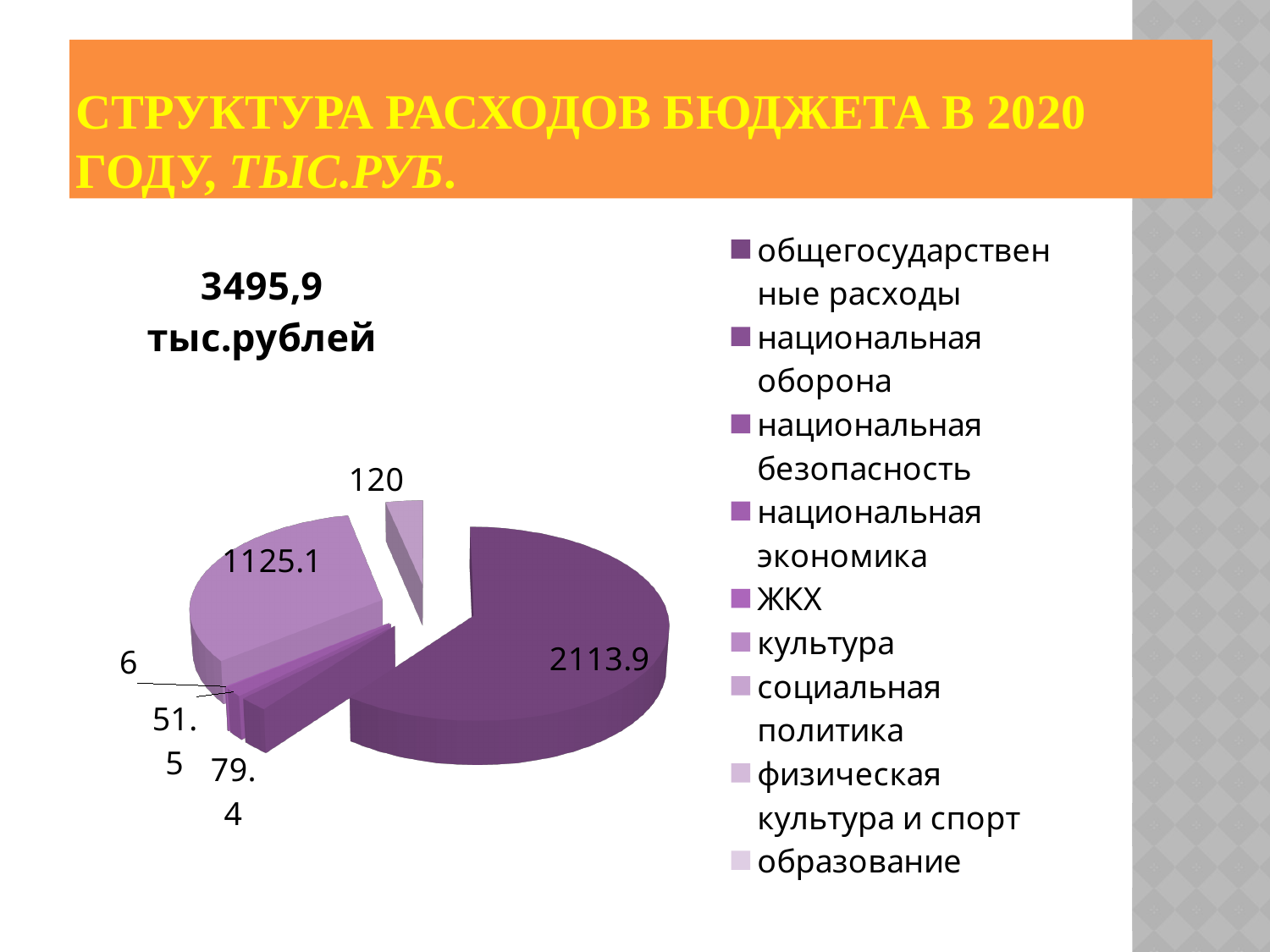
How many entries does the chart legend list? 9 How many data labels are printed on the pie chart? 6 What is the largest value labelled on the pie chart? 2113.9 What is the first entry listed in the chart legend? общегосударственные расходы What total amount is printed above the pie chart? 3495,9 тыс.рублей What is the smallest value labelled on the pie chart? 6 Which category has the largest slice of the pie? общегосударственные расходы Does the largest slice make up more than half of the pie? yes What kind of chart is shown on the slide? pie chart Which is larger, the slice labelled 1125.1 or the slice labelled 120? 1125.1 What is the difference between the slice labelled 2113.9 and the slice labelled 1125.1? 988.8 What is the difference between the slice labelled 120 and the slice labelled 79.4? 40.6